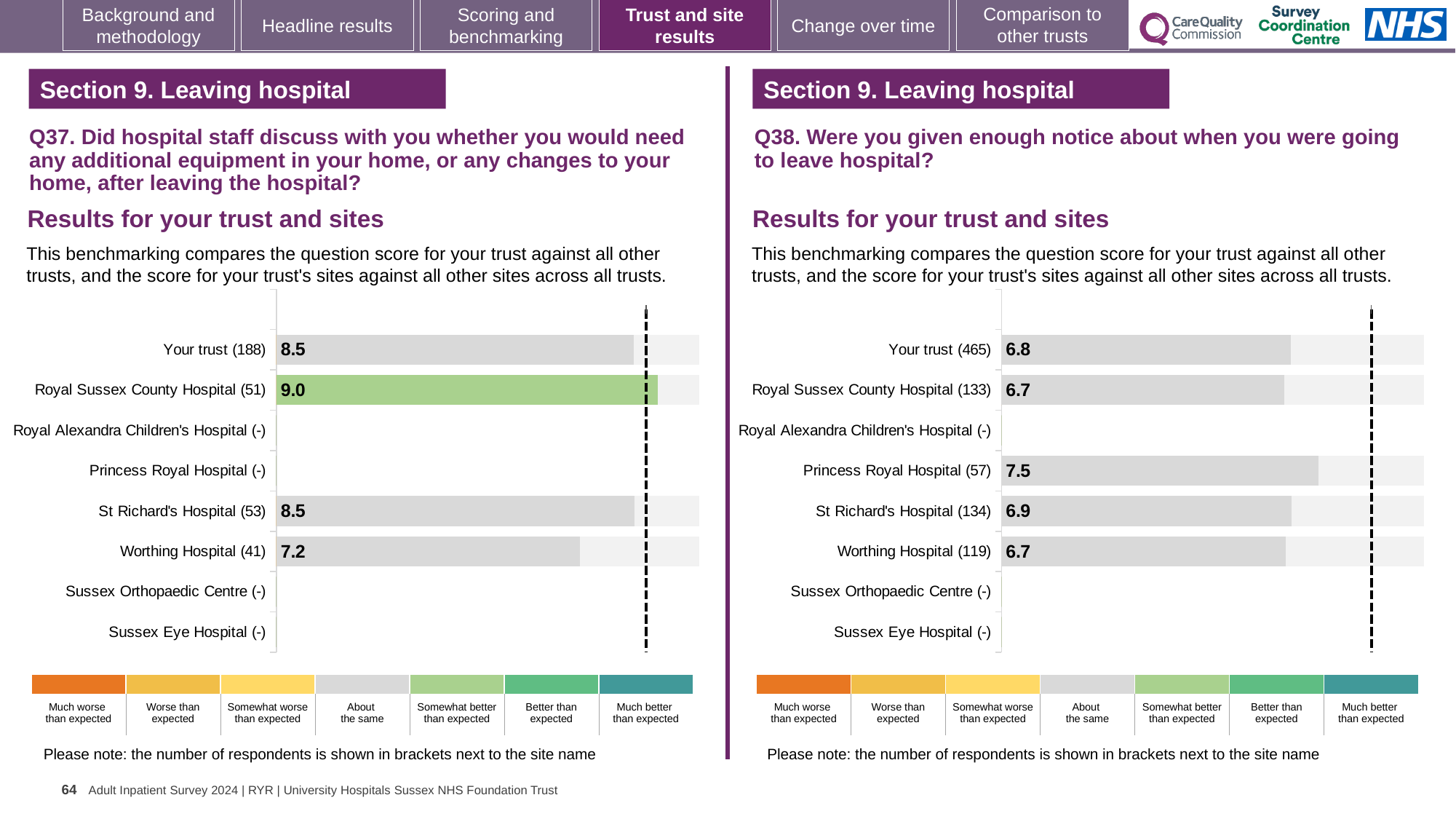
In the Q38 chart on the right, what is the score for Princess Royal Hospital (57)? 7.5 In the Q38 chart on the right, what is the difference between the scores for Princess Royal Hospital (57) and Your trust (465)? 0.7 In the Q37 chart on the left, what is the score for Worthing Hospital (41)? 7.2 In the Q38 chart on the right, which site has the highest score? Princess Royal Hospital (57) In the Q37 chart on the left, what is the score for Your trust (188)? 8.5 In the Q38 chart on the right, what is the score for St Richard's Hospital (134)? 6.9 In the Q37 chart on the left, which benchmark category does the green colour of the Royal Sussex County Hospital bar represent? Somewhat better than expected How many site rows (including Your trust) are listed in the Q37 chart on the left? 8 In the Q37 chart on the left, what is the difference between the scores for Royal Sussex County Hospital (51) and Worthing Hospital (41)? 1.8 What type of chart is used for the Q38 results on the right? Bar chart In the Q38 chart on the right, which is larger: the score for Your trust (465) or the score for Worthing Hospital (119)? Your trust (465) In the Q37 chart on the left, which site has the highest score? Royal Sussex County Hospital (51)